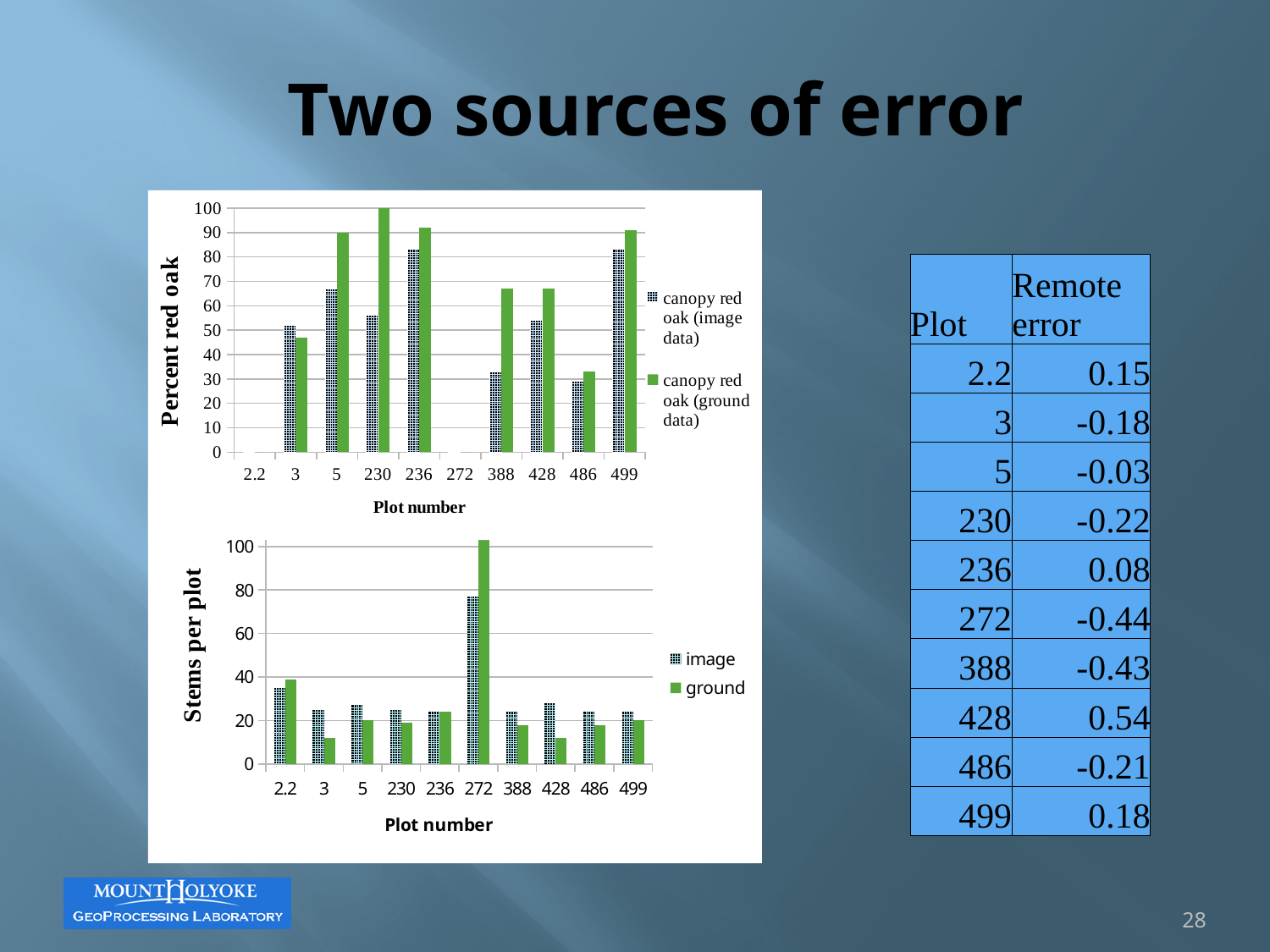
In the bottom chart (Stems per plot), is the image value for plot 2.2 greater or less than 40? less In the bottom chart (Stems per plot), which plot number has the highest value for the ground series? 272 What is the y-axis title of the top chart? Percent red oak In the top chart (Percent red oak), is the canopy red oak (image data) value for plot 388 greater or less than 40? less In the bottom chart (Stems per plot), is the ground value for plot 272 greater or less than 80? greater In the top chart (Percent red oak), for plot 388, which series has the larger value: canopy red oak (image data) or canopy red oak (ground data)? canopy red oak (ground data) In the bottom chart (Stems per plot), for plot 3, which series has the larger value: image or ground? image How many series does the legend of the top chart (Percent red oak) list? 2 In the top chart (Percent red oak), which plot number has the highest value for canopy red oak (ground data)? 230 How many plot numbers are shown on the x axis of the top chart (Percent red oak)? 10 What kind of chart is the bottom chart (Stems per plot)? bar chart